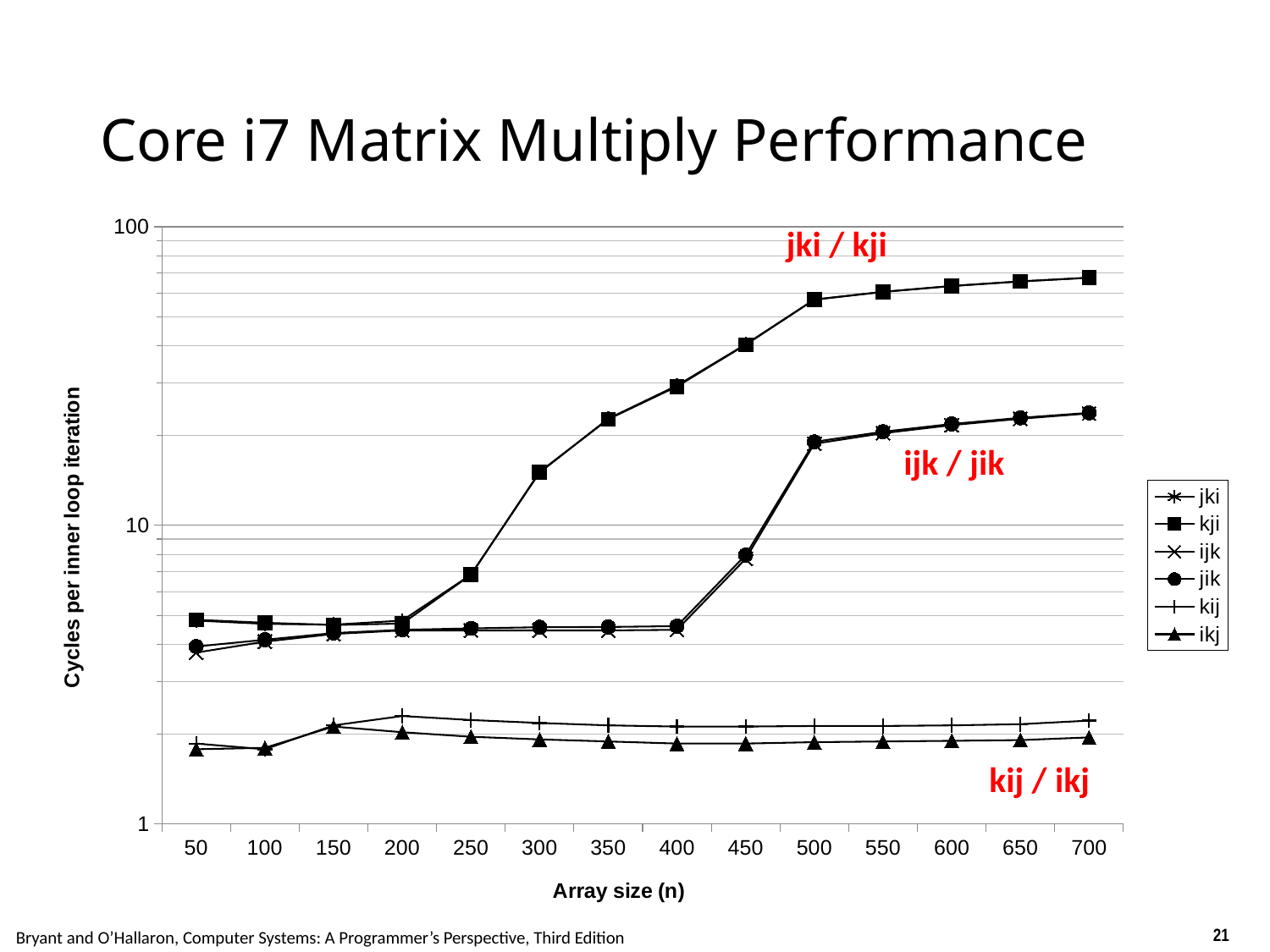
Is the value for jik at array size 500 greater or less than 10 cycles per inner loop iteration? greater Is the value for kij at array size 700 greater or less than 10 cycles per inner loop iteration? less How many array sizes (x-axis points) are plotted for each series? 14 Do the values for kji rise or fall as the array size increases from 200 to 700? rise Is the value for jik at array size 400 greater or less than 10 cycles per inner loop iteration? less Which labeled group of loop orderings has the highest cycles per inner loop iteration at array size 700? jki / kji What kind of chart is shown on the slide? line chart What is the label on the y axis of the chart? Cycles per inner loop iteration At array size 600, which is larger: the value for kji or the value for ikj? kji How many series does the legend list? 6 Which labeled group of loop orderings has the lowest cycles per inner loop iteration at array size 700? kij / ikj